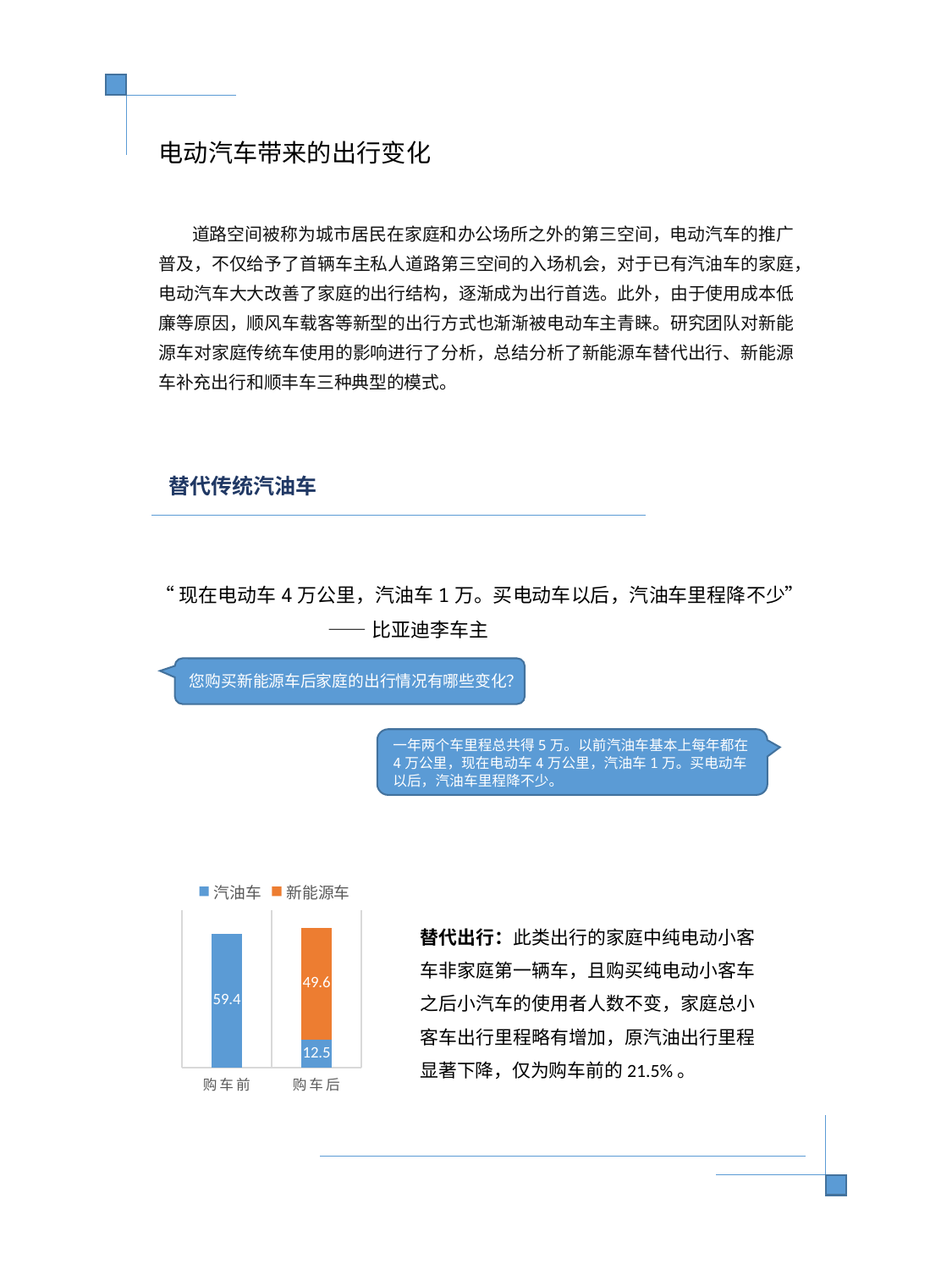
How many series does the chart legend list? 2 Which is larger in the 购车后 bar, the 汽油车 segment or the 新能源车 segment? 新能源车 What is the value for 汽油车 in the 购车前 bar? 59.4 Which colour represents 新能源车 in the chart? Orange What is the value for 新能源车 in the 购车后 bar? 49.6 What kind of chart is shown on the slide? Stacked bar chart Which category has the higher 汽油车 value, 购车前 or 购车后? 购车前 What is the total of the stacked 购车后 bar? 62.1 What is the difference between the 汽油车 value for 购车前 and the 汽油车 value for 购车后? 46.9 How many categories are shown on the x axis of the chart? 2 Does the 汽油车 value rise or fall from 购车前 to 购车后? Fall What is the value for 汽油车 in the 购车后 bar? 12.5